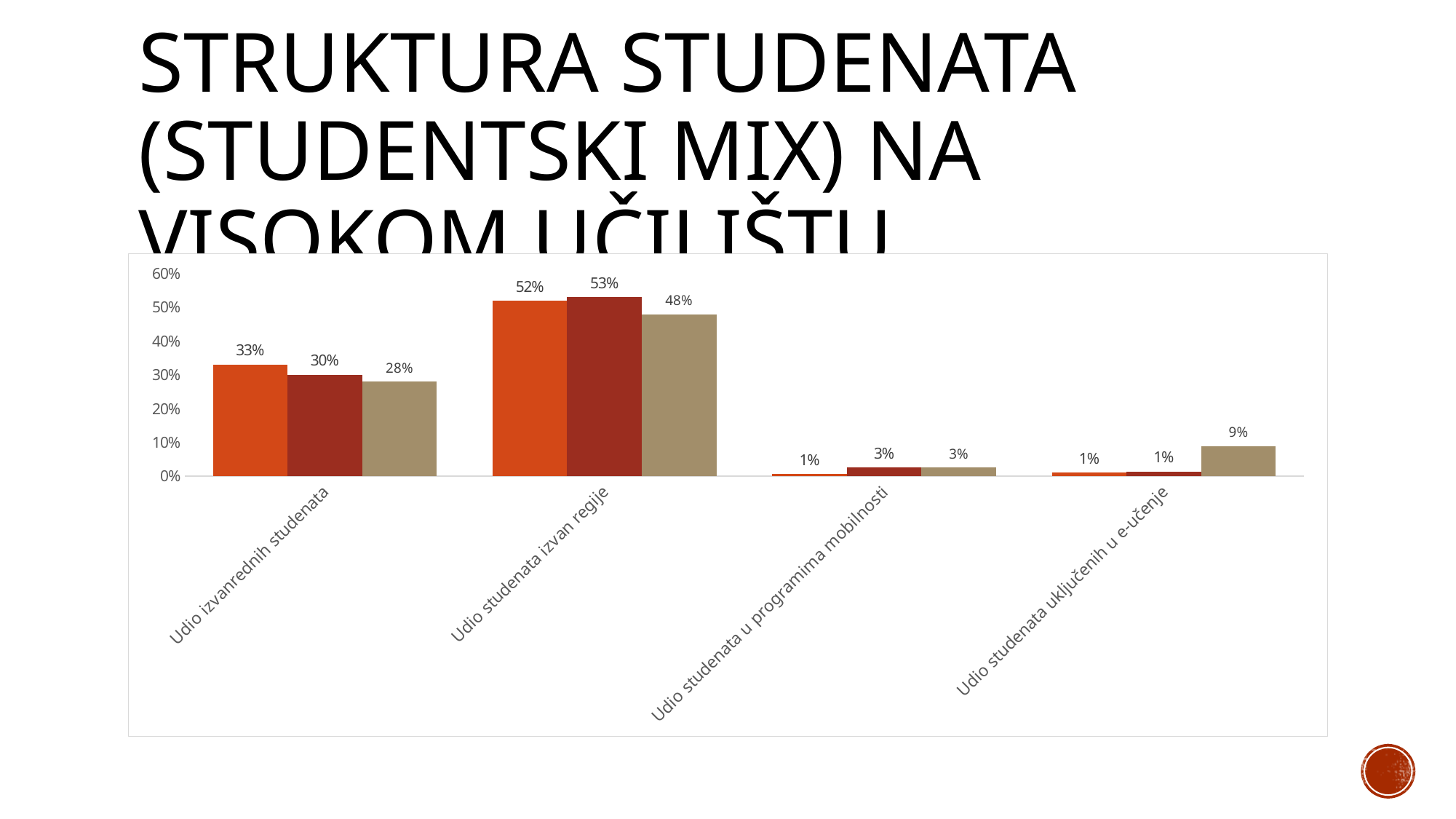
What is the difference between the first (orange) bar and the third (tan) bar for 'Udio izvanrednih studenata'? 5% What is the value of the first (orange) bar for 'Udio izvanrednih studenata'? 33% What is the value of the third (tan) bar for 'Udio studenata uključenih u e-učenje'? 9% How many categories are shown on the x axis of the chart? 4 Which is larger for 'Udio studenata izvan regije': the first (orange) bar or the third (tan) bar? the first (orange) bar Which category has the highest values in the chart? Udio studenata izvan regije Is the value of the second (dark red) bar for 'Udio studenata izvan regije' greater or less than 50%? greater How many bars are shown for each category in the chart? 3 What kind of chart is shown on the slide? bar chart What is the value of the third (tan) bar for 'Udio studenata izvan regije'? 48% What is the difference between the second (dark red) bar and the third (tan) bar for 'Udio studenata izvan regije'? 5% What is the value of the second (dark red) bar for 'Udio studenata u programima mobilnosti'? 3%